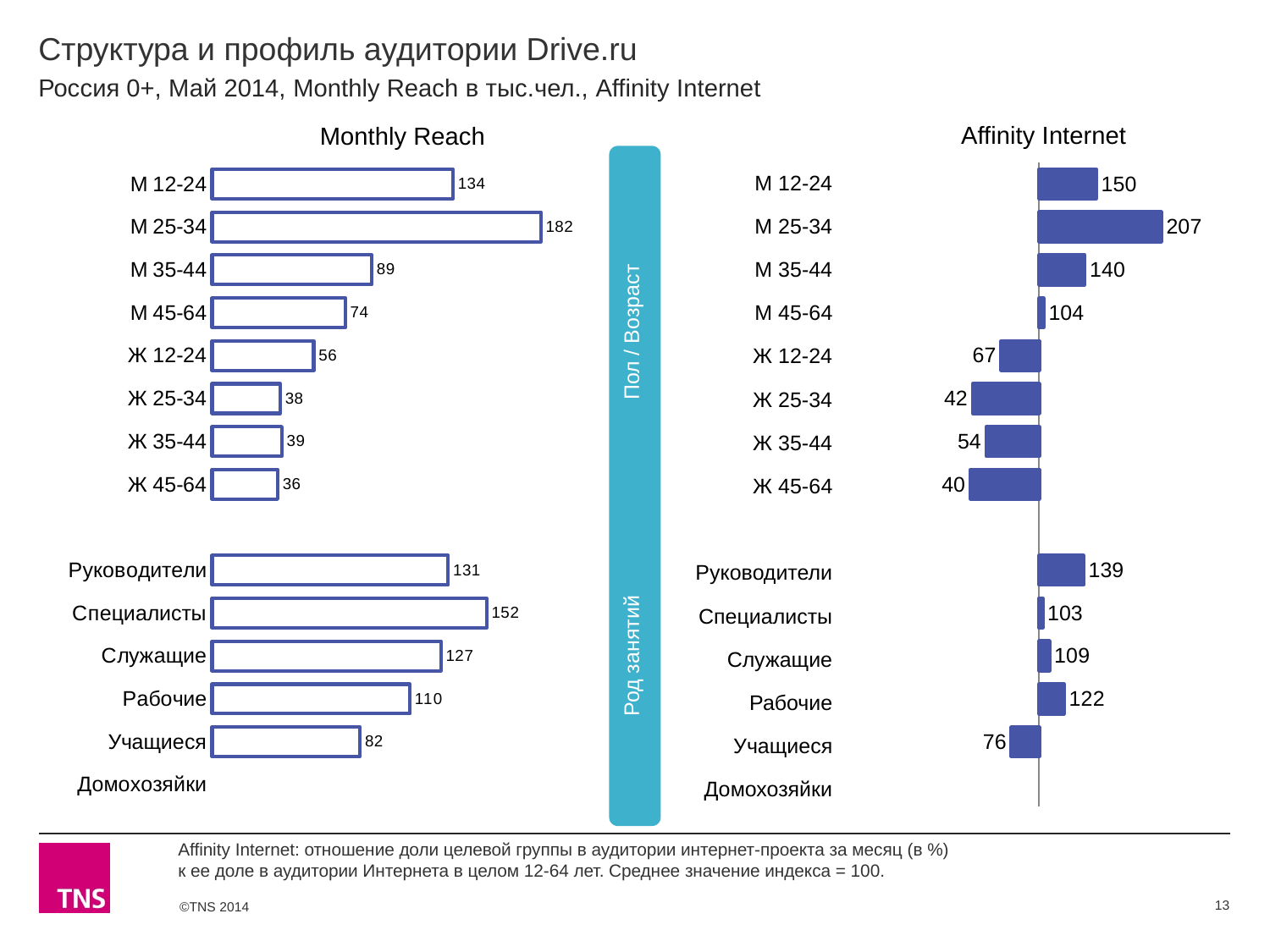
In the Affinity Internet chart, what is the value for Специалисты? 103 What kind of chart is the Monthly Reach chart? Bar chart In the Affinity Internet chart, which category has the lowest value? Ж 45-64 In the Monthly Reach chart, what is the value for Учащиеся? 82 In the Monthly Reach chart, do the values rise or fall across the male age groups from М 25-34 to М 45-64? Fall In the Affinity Internet chart, which is larger: Ж 12-24 or Ж 35-44? Ж 12-24 In the Affinity Internet chart, what is the value for Рабочие? 122 In the Monthly Reach chart, what is the value for М 25-34? 182 In the Monthly Reach chart, what is the difference between Специалисты and Руководители? 21 In the Monthly Reach chart, which is larger: Служащие or Рабочие? Служащие In the Affinity Internet chart, what is the difference between М 25-34 and М 12-24? 57 In the Monthly Reach chart, which category has the highest value? М 25-34